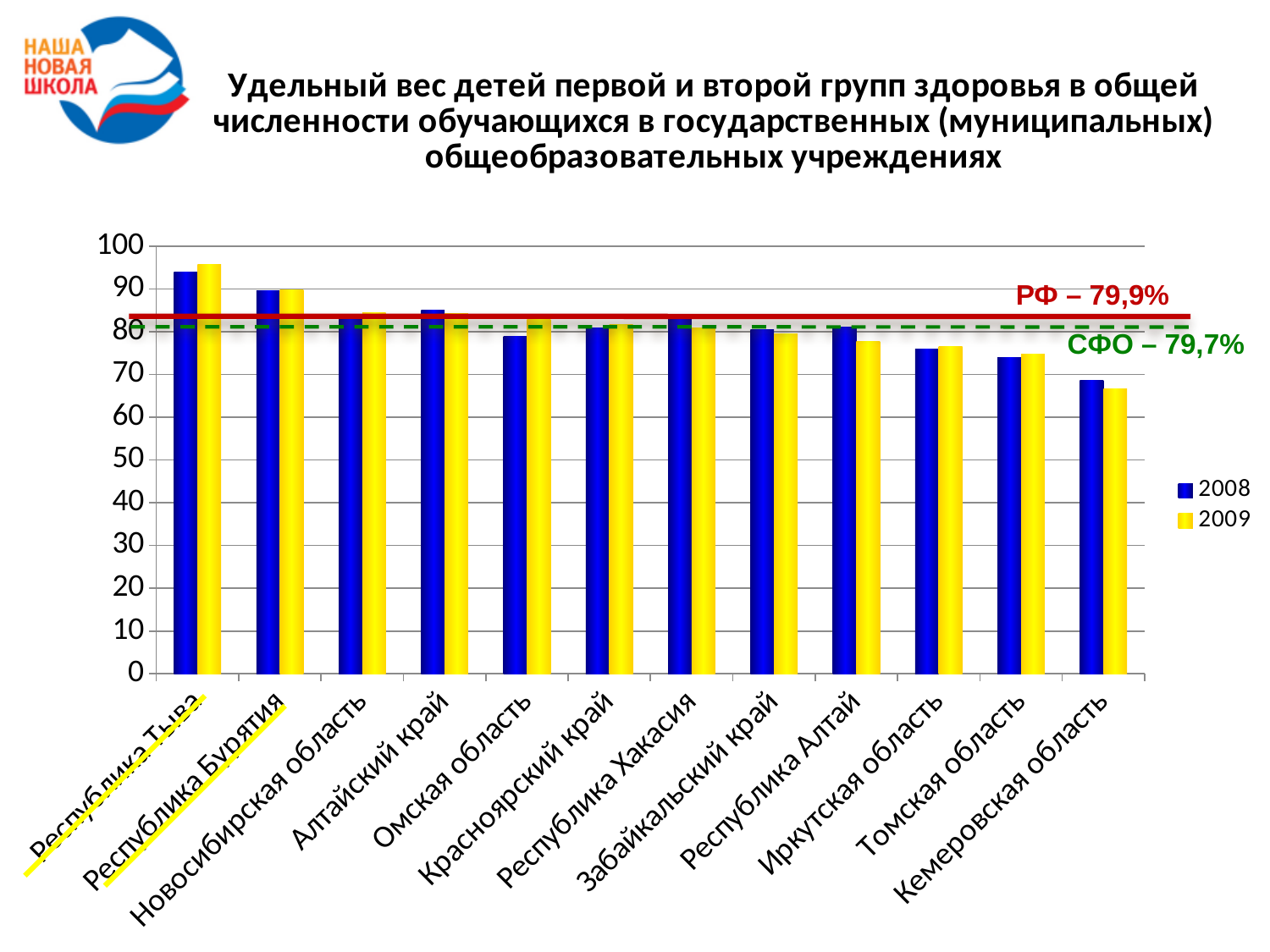
Which region has the highest value in the chart? Республика Тыва For Республика Тыва, which year has the larger value, 2008 or 2009? 2009 What value is shown for the red reference line labelled РФ? 79,9% Which region has the lowest value in the chart? Кемеровская область How many regions (categories) are shown on the x axis of the chart? 12 Is the 2009 value for Республика Тыва greater or less than 90? greater Do the values generally rise or fall moving from left to right along the x axis? fall Is the 2008 value for Кемеровская область greater or less than 70? less How many series does the chart legend list? 2 For Кемеровская область, which year has the larger value, 2008 or 2009? 2008 Is the 2009 value for Иркутская область greater or less than 80? less What kind of chart is shown on the slide? bar chart